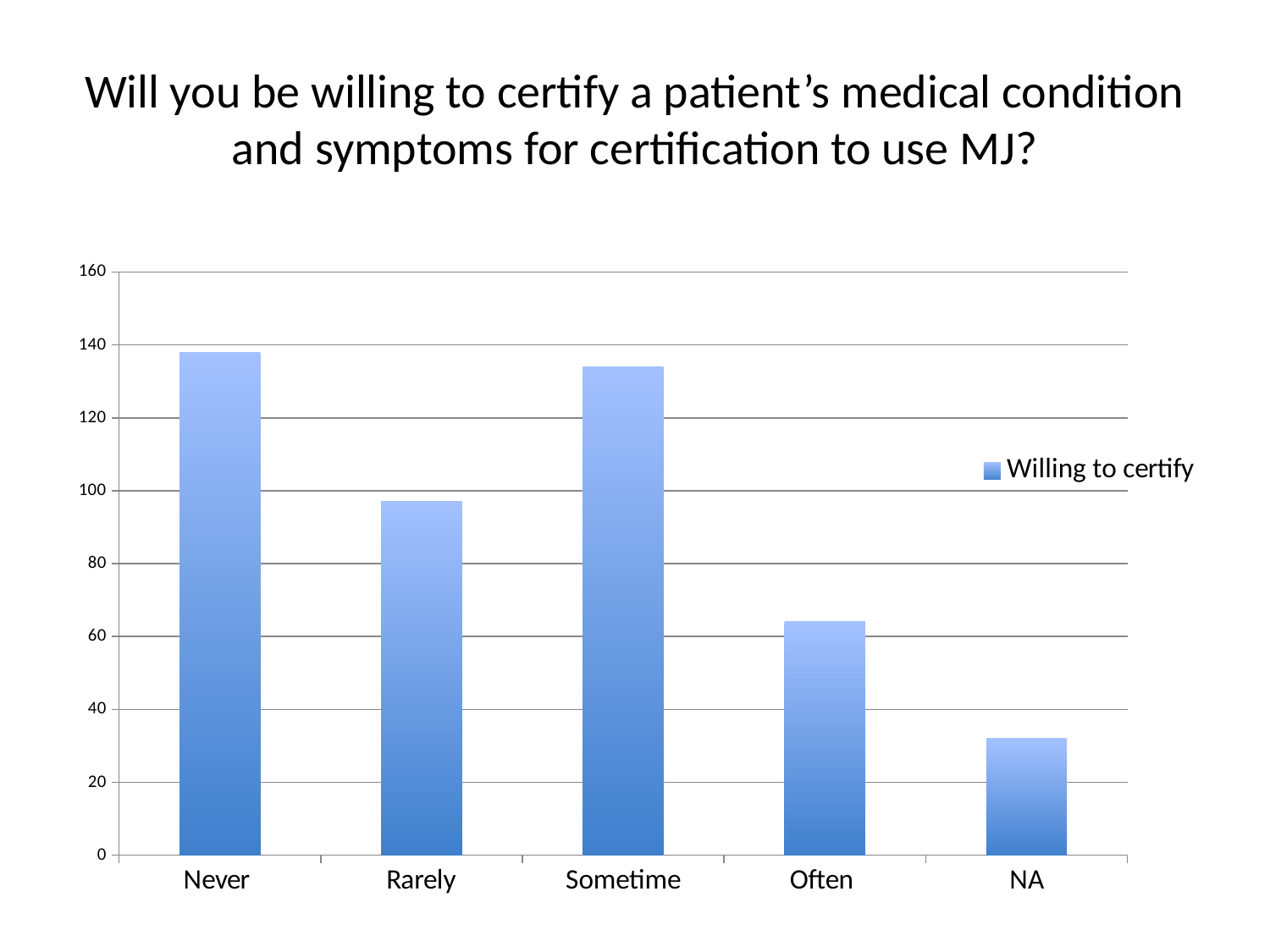
Which category has the lowest value in the chart? NA How many series does the chart's legend list? 1 Is the value for Rarely greater or less than 100? less Is the value for Often greater or less than 80? less Which is larger, the value for Rarely or the value for Often? Rarely How many categories are shown on the x axis of the chart? 5 What kind of chart is shown on the slide? bar chart What is the name of the series shown in the chart's legend? Willing to certify Is the value for Never greater or less than 120? greater Which is larger, the value for Often or the value for NA? Often